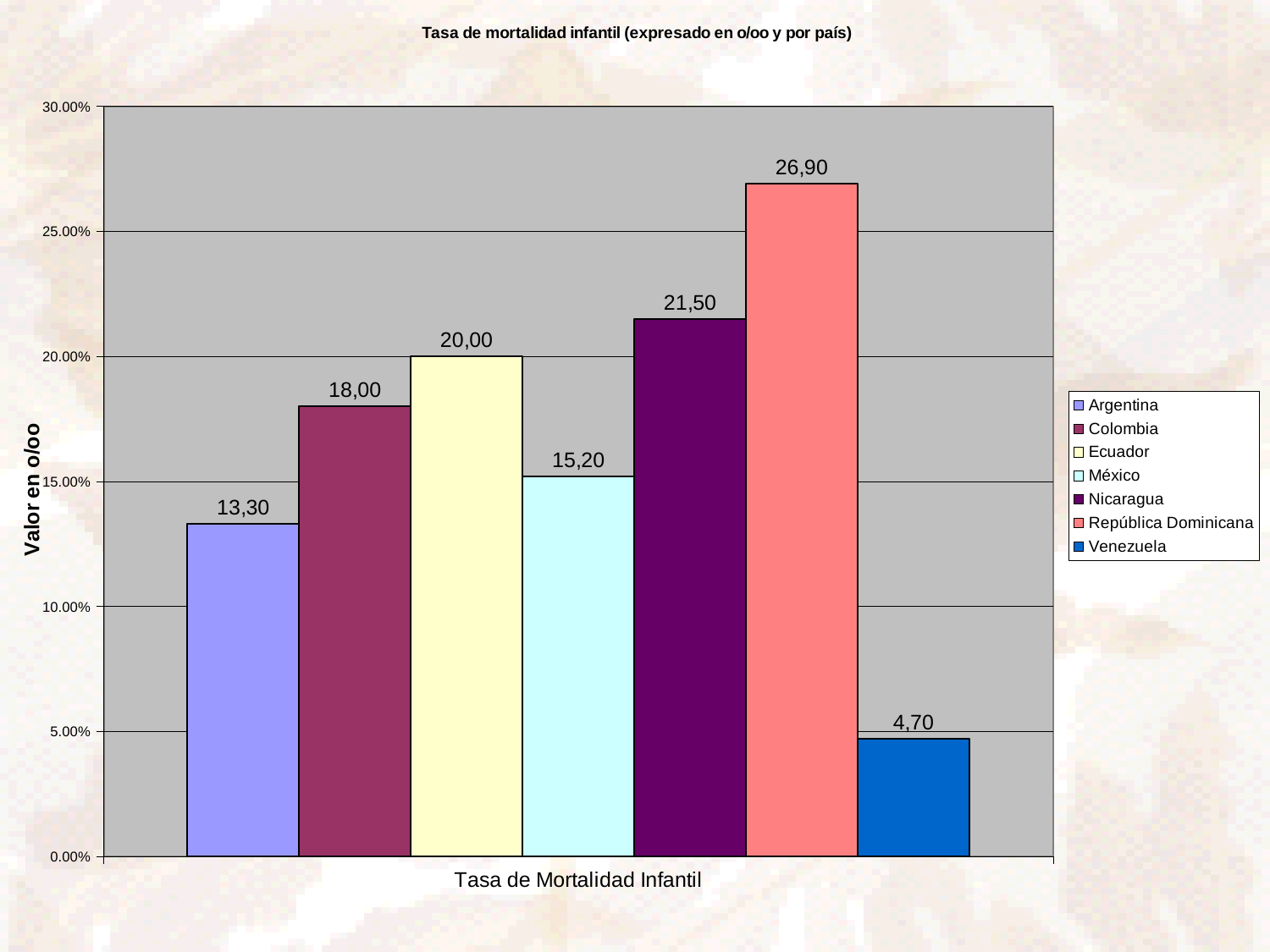
Which country has the highest value? República Dominicana Which has a larger value, Ecuador or México? Ecuador Is the value for Nicaragua greater or less than 20.00%? greater How many countries are plotted in the chart? 7 Which country has the lowest value? Venezuela What kind of chart is shown? bar chart What is the label of the vertical axis? Valor en o/oo How many entries does the legend list? 7 What is the value shown for Venezuela? 4,70 What is the value shown for República Dominicana? 26,90 What is the difference between the values for Nicaragua and Colombia? 3,50 What is the value shown for Argentina? 13,30